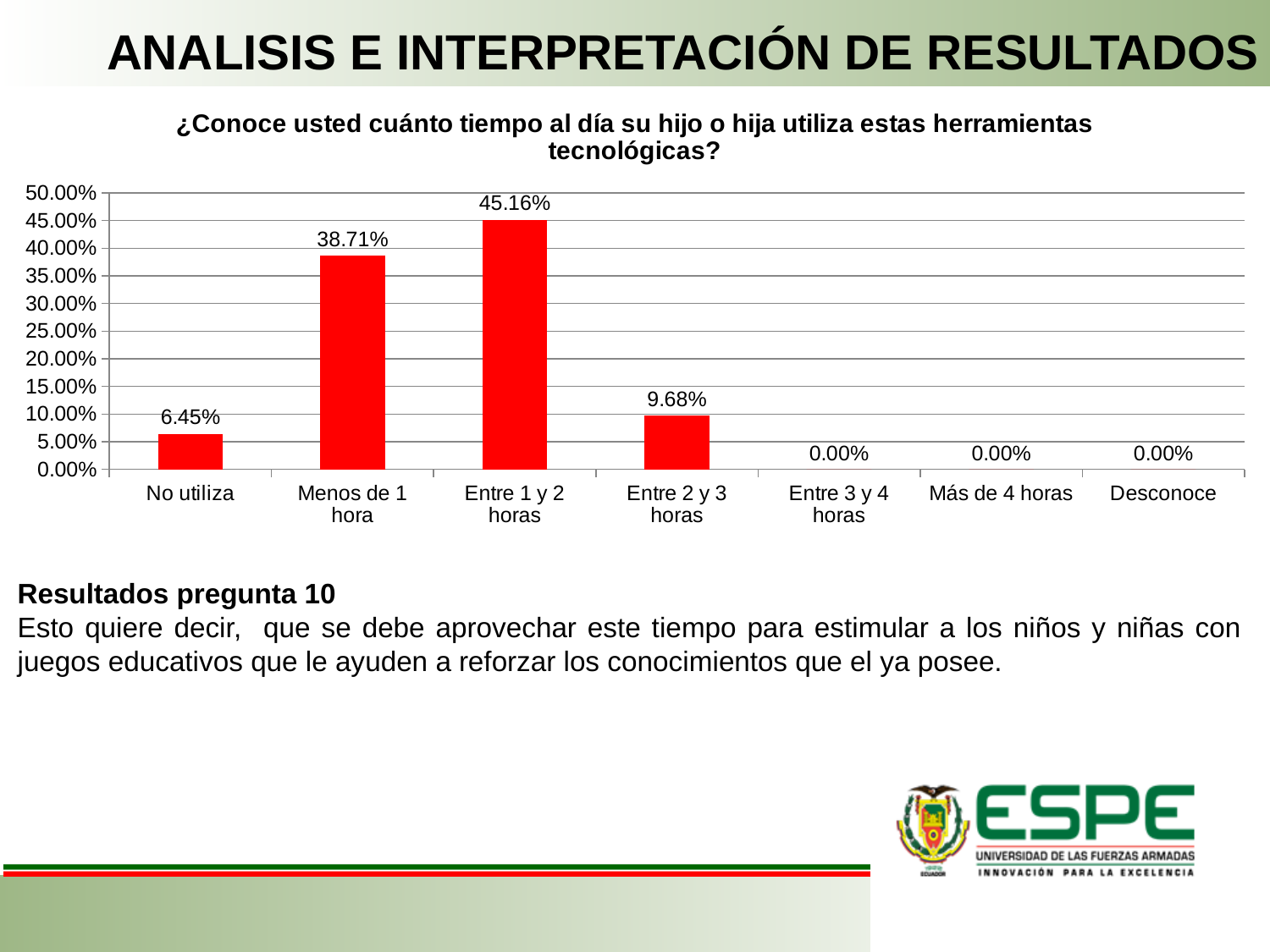
What is the value for "No utiliza"? 6.45% What kind of chart is shown on the slide? bar chart Which is larger, the value for "No utiliza" or the value for "Entre 2 y 3 horas"? Entre 2 y 3 horas What colour are the bars in the chart? red What is the difference between the values for "Entre 1 y 2 horas" and "Menos de 1 hora"? 6.45% Is the value for "Menos de 1 hora" greater or less than 35.00%? greater What is the value for "Menos de 1 hora"? 38.71% How many categories have a value of 0.00%? 3 How many categories are shown on the x axis? 7 Which category has the highest value? Entre 1 y 2 horas What is the value for "Entre 1 y 2 horas"? 45.16% What is the value for "Entre 2 y 3 horas"? 9.68%